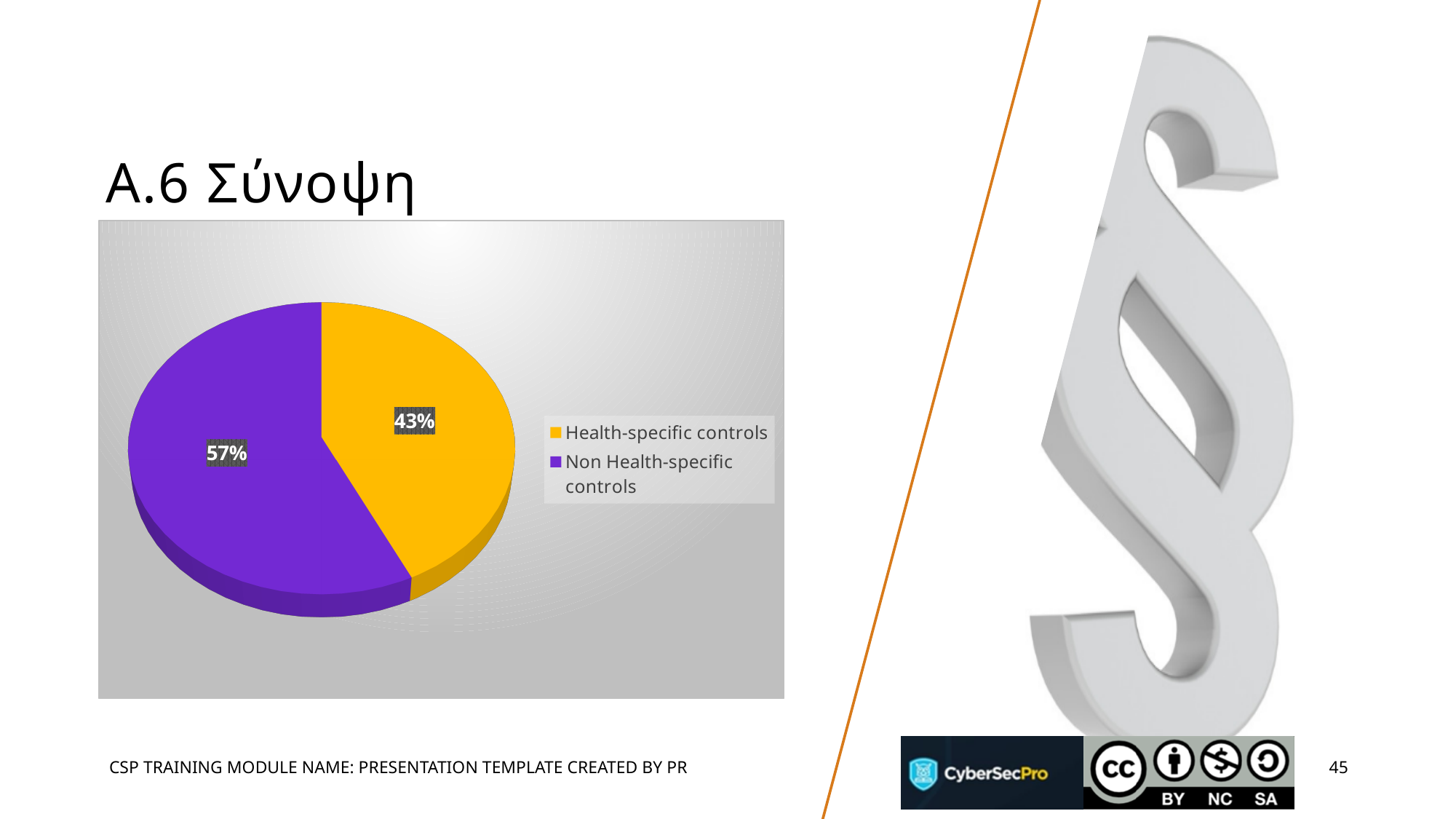
What is the difference in percentage points between Non Health-specific controls and Health-specific controls? 14 What kind of chart is shown on the slide? Pie chart How many slices does the pie chart have? 2 What percentage of the pie chart is Health-specific controls? 43% What percentage of the pie chart is Non Health-specific controls? 57% Is the share for Health-specific controls greater or less than 50%? less Which category has the smallest share of the pie chart? Health-specific controls What colour is the slice for Non Health-specific controls? Purple Which category has the largest share of the pie chart? Non Health-specific controls Which is larger: the share for Health-specific controls or for Non Health-specific controls? Non Health-specific controls What colour is the slice for Health-specific controls? Yellow How many entries does the chart legend list? 2